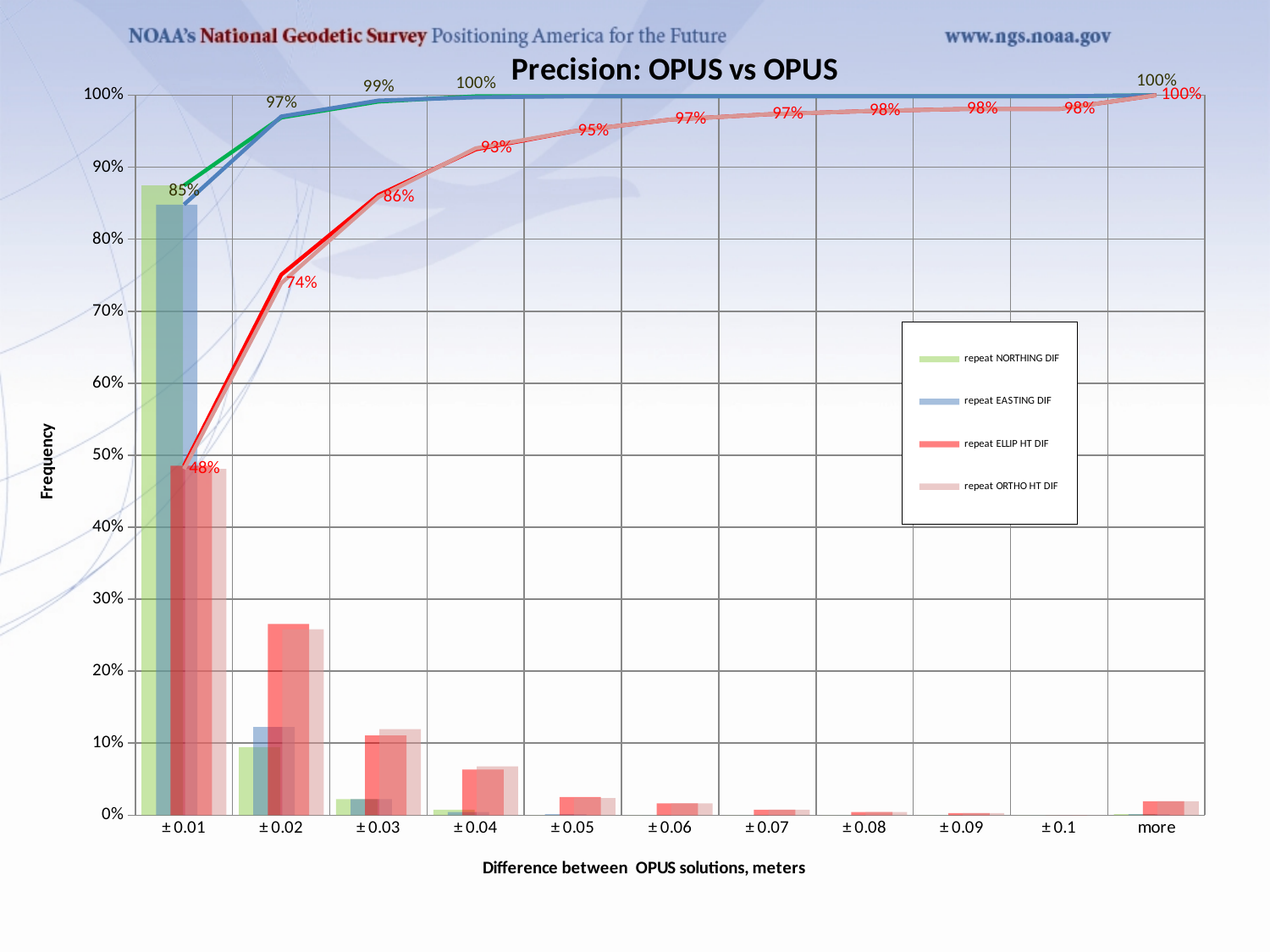
Which category has the tallest repeat NORTHING DIF bar? ± 0.01 What value is labelled on the red cumulative line at ±0.05? 95% What kind of chart is this? Combined bar and line chart Does the red cumulative line rise or fall from ±0.01 to more? rise What is the title of the chart? Precision: OPUS vs OPUS How many categories are shown on the x axis? 11 At ±0.02, what is the difference between the upper cumulative line label (97%) and the red cumulative line label (74%)? 23 percentage points Is the repeat ELLIP HT DIF bar at ±0.02 greater or less than 20%? greater What value is labelled on the red cumulative line at ±0.02? 74% How many series does the legend list? 4 What value is labelled on the red cumulative line at ±0.03? 86% What value is labelled on the upper (blue/green) cumulative line at ±0.02? 97%